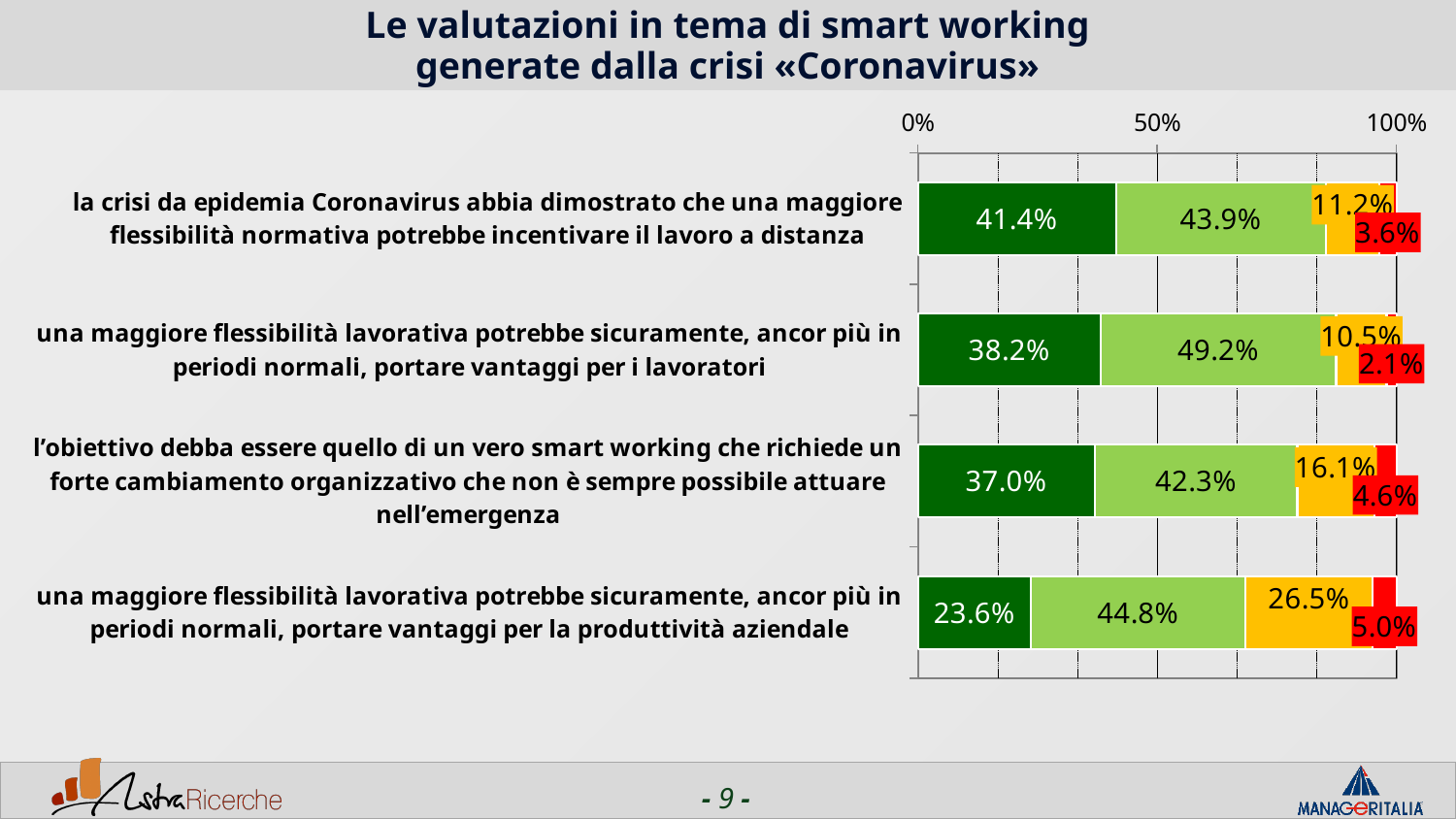
Which statement has the highest yellow value? una maggiore flessibilità lavorativa potrebbe sicuramente, ancor più in periodi normali, portare vantaggi per la produttività aziendale Which statement has the lowest red value? una maggiore flessibilità lavorativa potrebbe sicuramente, ancor più in periodi normali, portare vantaggi per i lavoratori What is the combined dark green and light green share for the statement about a true smart working requiring a strong organisational change? 79.3% What is the difference between the dark green values for the statement about advantages for workers (38.2%) and the statement about advantages for company productivity (23.6%)? 14.6% How many statements (categories) are plotted in the chart? 4 What is the red value for the statement about a true smart working requiring a strong organisational change? 4.6% Which statement has the highest dark green value? la crisi da epidemia Coronavirus abbia dimostrato che una maggiore flessibilità normativa potrebbe incentivare il lavoro a distanza What is the light green value for the statement that the Coronavirus crisis showed that greater regulatory flexibility could encourage remote work? 43.9% What is the yellow value for the statement about greater flexibility bringing advantages for workers ("vantaggi per i lavoratori")? 10.5% Which is larger: the light green value for the statement about advantages for workers or the light green value for the statement about a true smart working requiring organisational change? the statement about advantages for workers (49.2%) What kind of chart is shown on the slide? stacked bar chart What is the dark green value for the statement about a greater flexibility bringing advantages for company productivity ("vantaggi per la produttività aziendale")? 23.6%